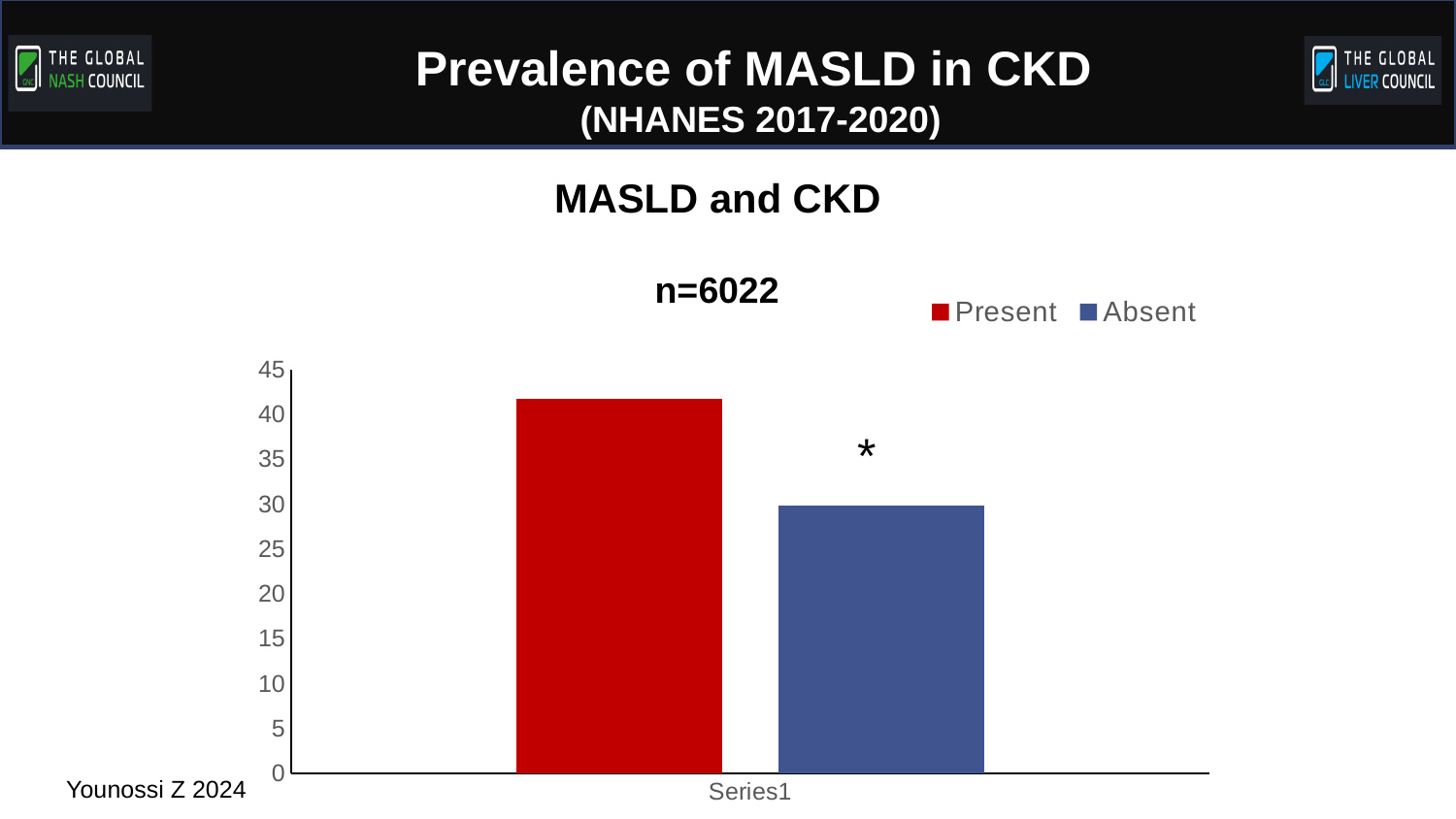
What colour is the bar for the Present series? red Which series has the taller bar, Present or Absent? Present Is the value for Absent greater or less than 25? greater Which series has the highest value? Present How many categories are shown on the x axis? 1 What kind of chart is shown on the slide? bar chart Is the value for Present greater or less than 45? less What is the title of the chart? MASLD and CKD How many series does the legend list? 2 Is the value for Absent greater or less than 35? less Which series has the lowest value? Absent